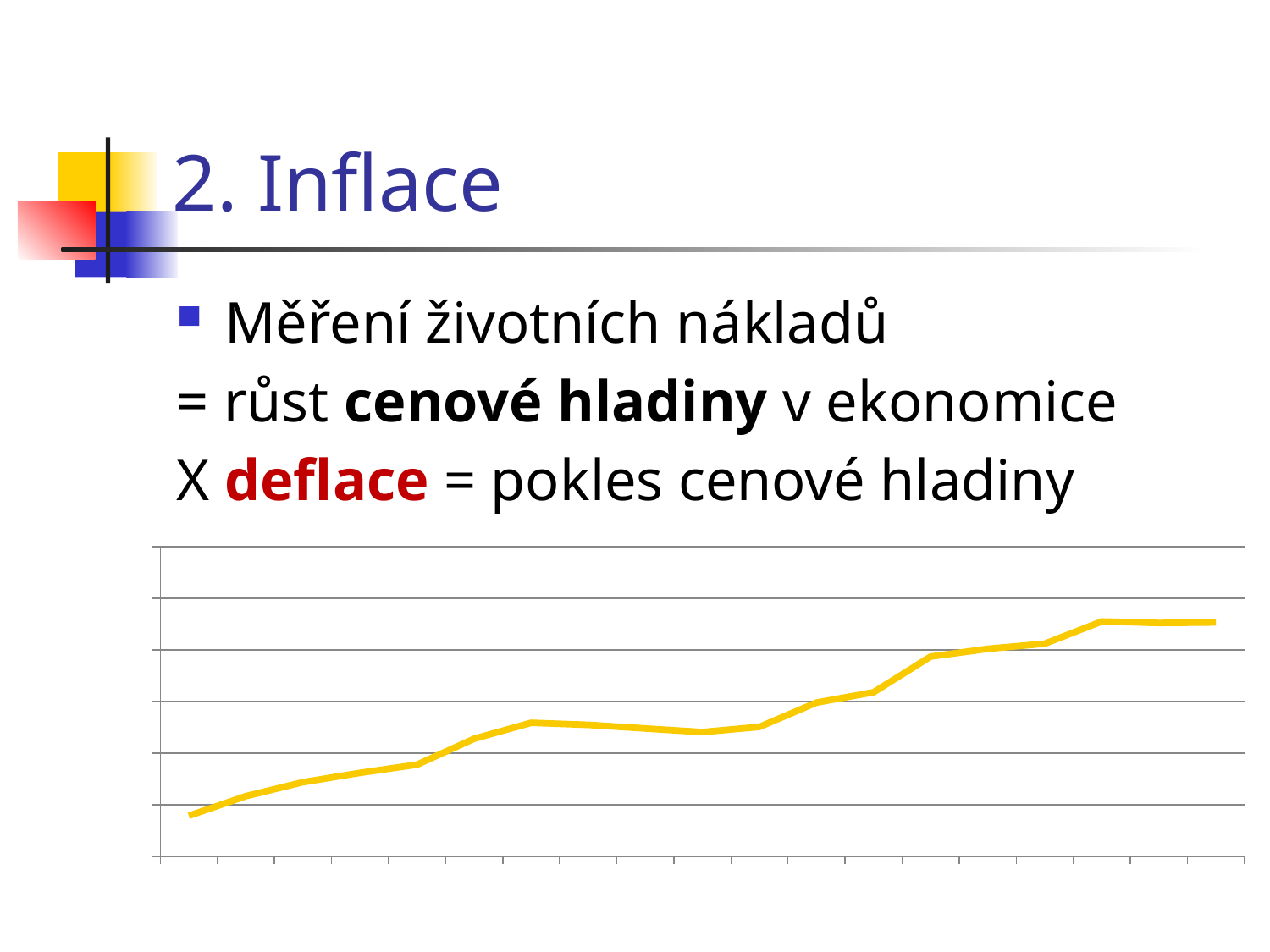
Do the values in the line chart generally rise or fall from left to right? rise Is the line's value at the right end of the chart higher or lower than at the left end? higher Is the lowest point of the line at the left end or the right end of the chart? left end What kind of chart is shown at the bottom of the slide? line chart How many lines are plotted in the chart? 1 What colour is the line in the chart? yellow Does the chart display a legend? No